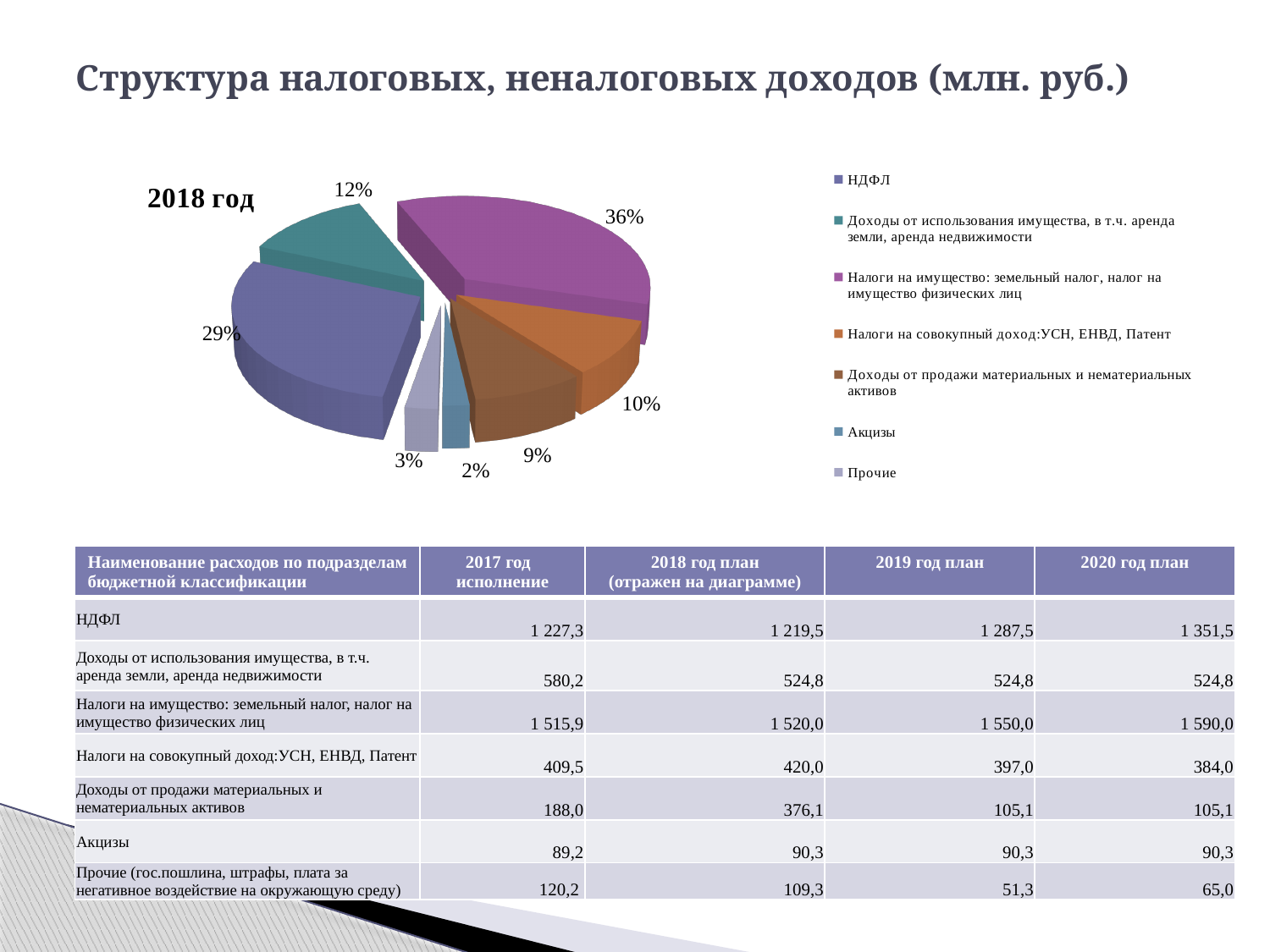
Which slice is larger in the pie chart: НДФЛ or Налоги на совокупный доход:УСН, ЕНВД, Патент? НДФЛ By how many percentage points does the Налоги на имущество slice exceed the НДФЛ slice in the pie chart? 7 What year does the pie chart represent? 2018 год Which category has the smallest slice in the pie chart? Акцизы What percentage is shown for Доходы от использования имущества, в т.ч. аренда земли, аренда недвижимости in the pie chart? 12% Which category has the largest slice in the pie chart? Налоги на имущество: земельный налог, налог на имущество физических лиц How many slices does the pie chart have? 7 What percentage is shown for Акцизы in the pie chart? 2% What kind of chart is shown on the slide? Pie chart What share of the pie chart is labelled for Налоги на имущество: земельный налог, налог на имущество физических лиц? 36% How many entries does the legend of the pie chart list? 7 What share of the pie chart does НДФЛ take? 29%